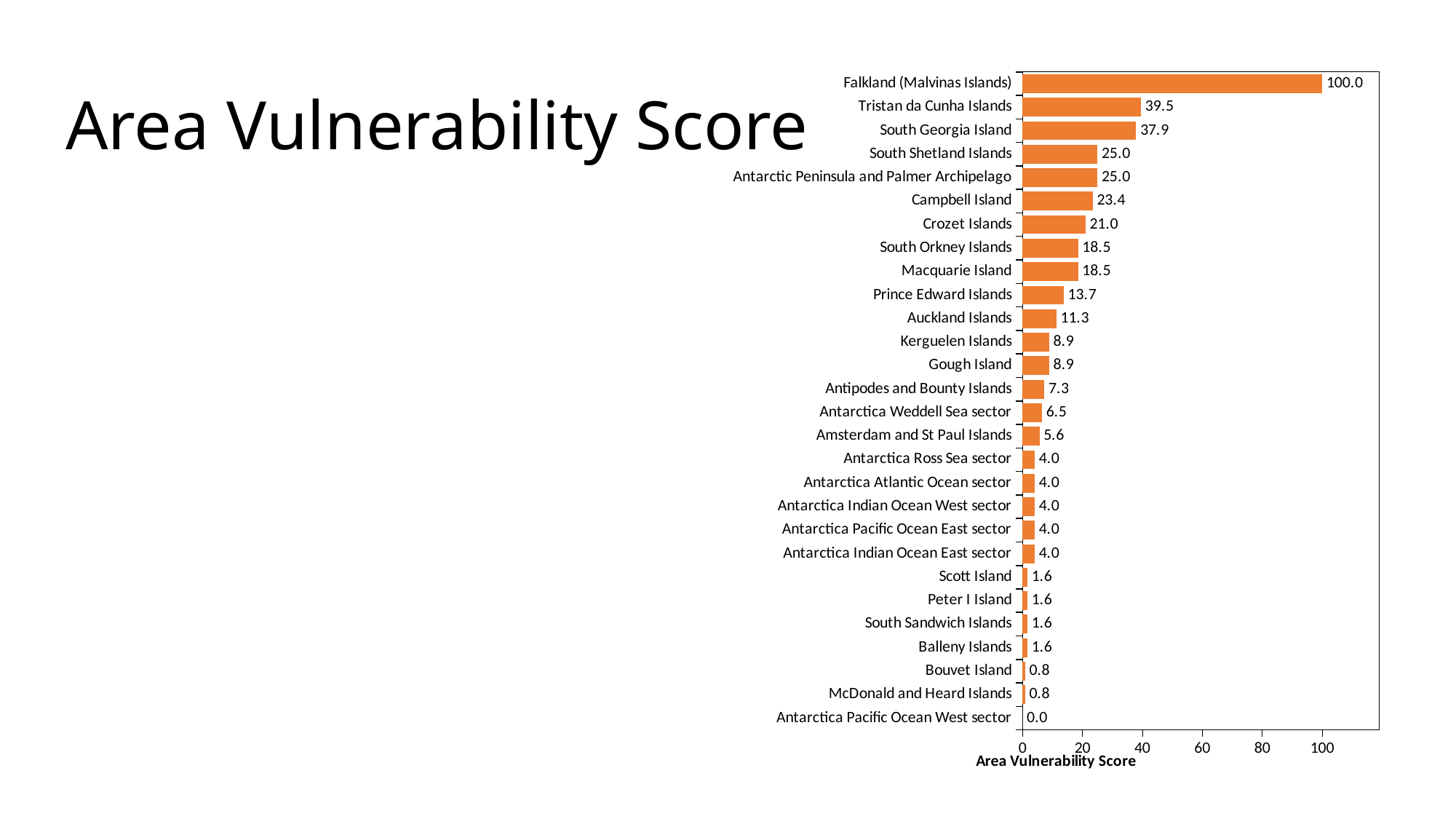
Is the Area Vulnerability Score for South Georgia Island greater or less than 20? greater What is the difference between the Area Vulnerability Scores of Crozet Islands and Prince Edward Islands? 7.3 Which area has the lowest Area Vulnerability Score? Antarctica Pacific Ocean West sector What is the Area Vulnerability Score for Campbell Island? 23.4 What type of chart is shown on the slide? Bar chart What is the difference between the Area Vulnerability Scores of Falkland (Malvinas Islands) and South Georgia Island? 62.1 What is the Area Vulnerability Score for Tristan da Cunha Islands? 39.5 How many areas are shown in the chart? 28 Which area has the highest Area Vulnerability Score? Falkland (Malvinas Islands) What is the Area Vulnerability Score for Auckland Islands? 11.3 What is the label on the horizontal axis of the chart? Area Vulnerability Score Which has a higher Area Vulnerability Score, South Shetland Islands or Macquarie Island? South Shetland Islands